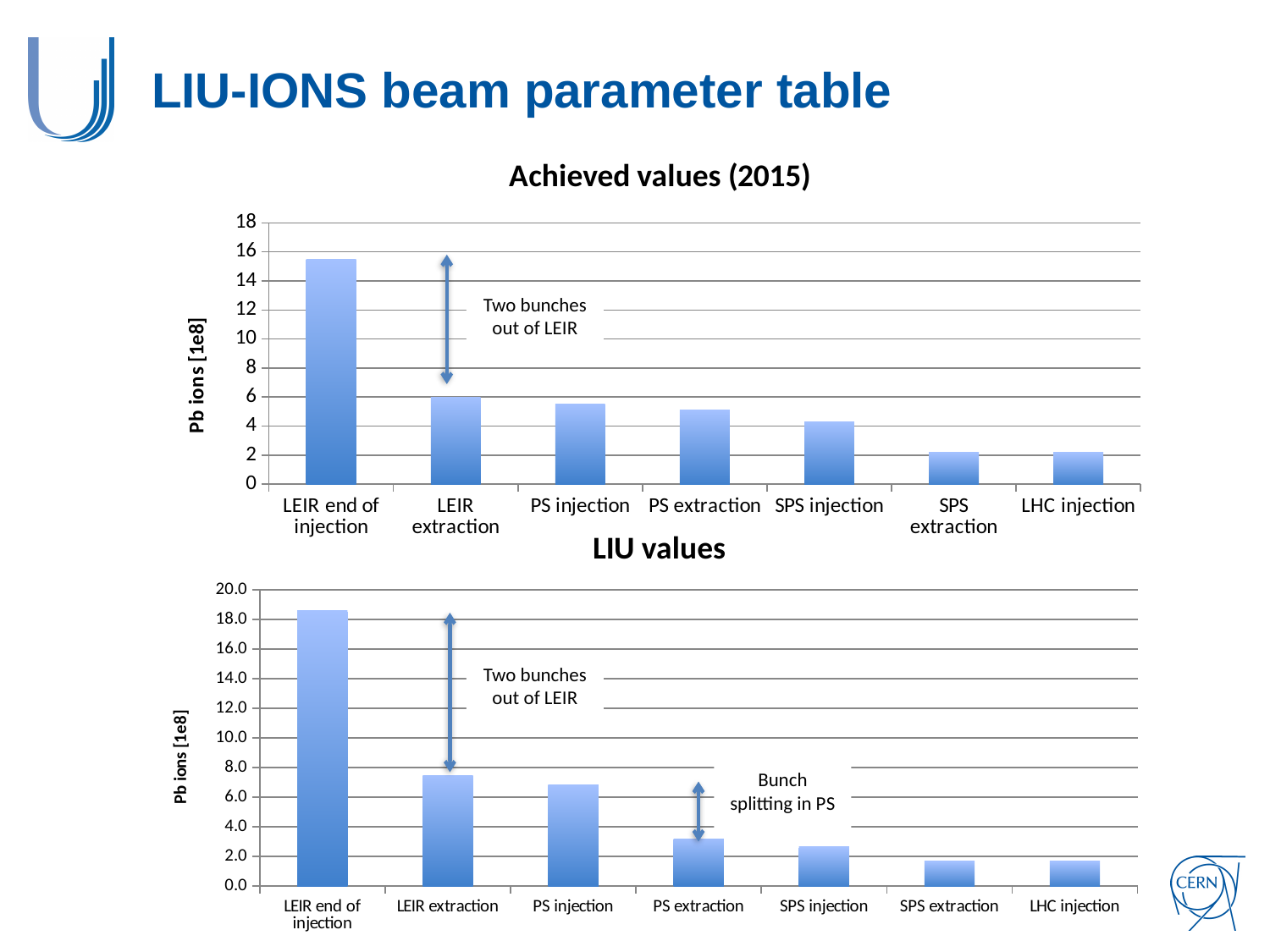
What kind of chart is the 'Achieved values (2015)' chart? bar chart In the 'LIU values' chart, is the value for LEIR extraction greater or less than 6.0? greater In the 'Achieved values (2015)' chart, which category has the highest value? LEIR end of injection In the 'LIU values' chart, which is larger, PS injection or PS extraction? PS injection In the 'Achieved values (2015)' chart, is the value for SPS injection greater or less than 6? less In the 'LIU values' chart, is the value for PS extraction greater or less than 4.0? less In the 'Achieved values (2015)' chart, which is larger, LEIR extraction or SPS injection? LEIR extraction In the 'LIU values' chart, do the values generally rise or fall from left to right along the x axis? fall How many categories are shown on the x axis of the 'LIU values' chart? 7 In the 'LIU values' chart, which category has the highest value? LEIR end of injection